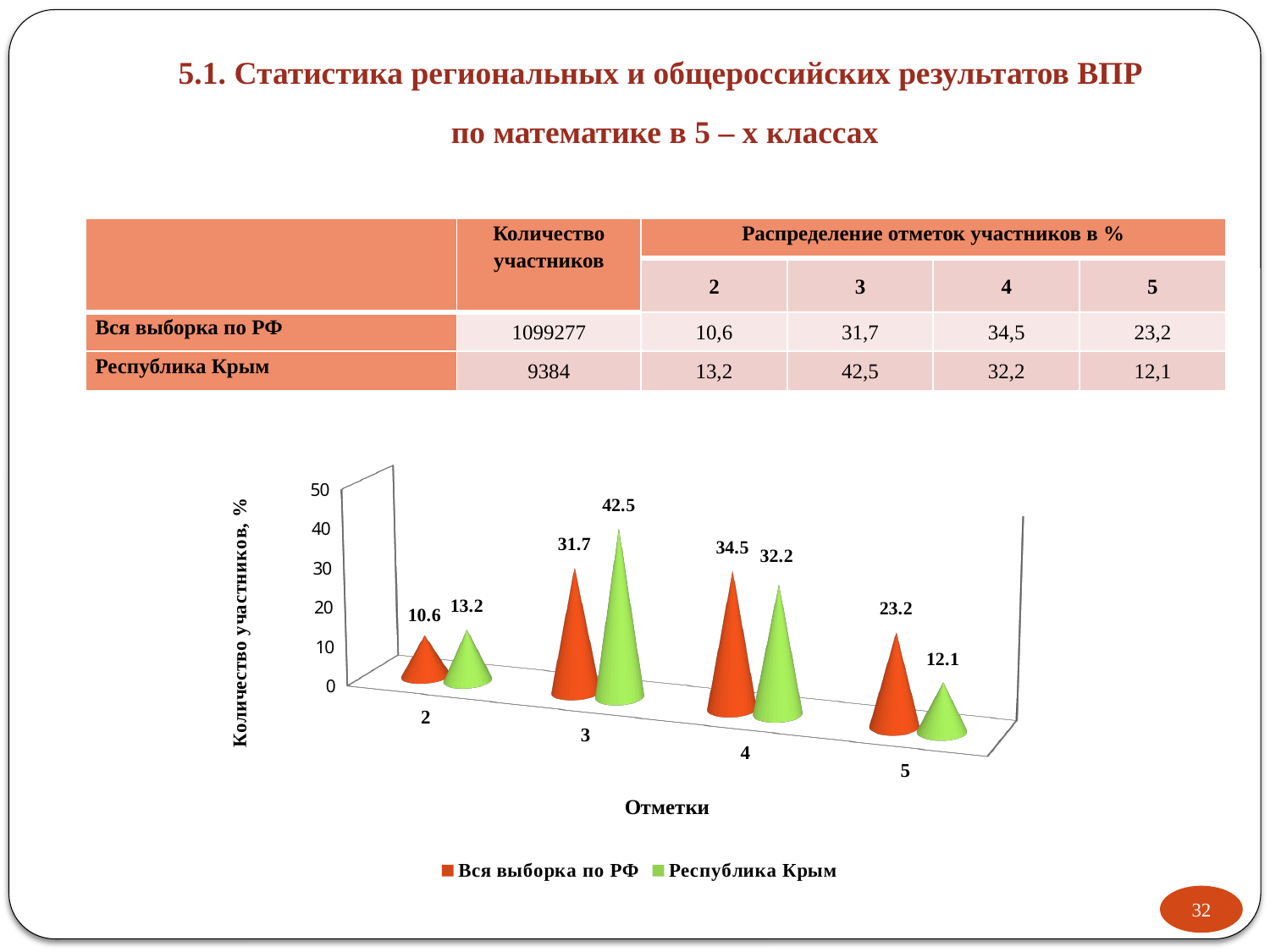
For which mark is the value for Республика Крым highest? 3 How many marks (categories) are shown on the x axis of the chart? 4 What is the value for Республика Крым at mark 5? 12.1 What kind of chart is shown on the slide? bar chart For which mark is the value for Вся выборка по РФ lowest? 2 What is the difference between Республика Крым and Вся выборка по РФ at mark 3? 10.8 What is the value for Республика Крым at mark 3? 42.5 At mark 5, which series has the larger value, Вся выборка по РФ or Республика Крым? Вся выборка по РФ How many series does the chart legend list? 2 What is the label of the x axis of the chart? Отметки What is the value for Вся выборка по РФ at mark 2? 10.6 What is the value for Вся выборка по РФ at mark 4? 34.5